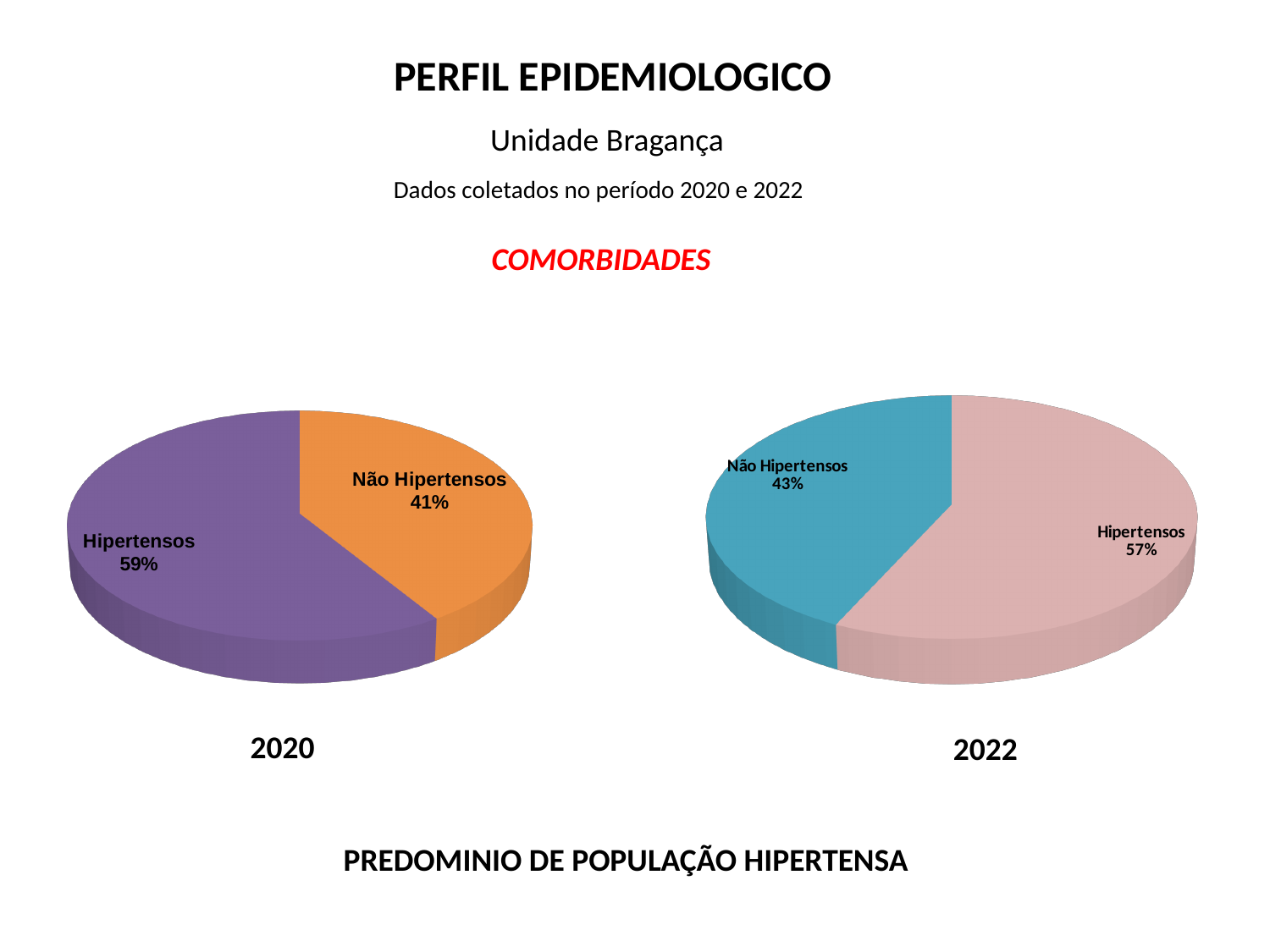
Is the Hipertensos share larger in the 2020 pie chart or the 2022 pie chart? 2020 How many slices does the 2020 pie chart have? 2 In the 2020 pie chart, what percentage is labelled for Hipertensos? 59% In the 2022 pie chart, what colour is the Não Hipertensos slice? Teal/blue In the 2020 pie chart, what percentage is labelled for Não Hipertensos? 41% In the 2020 pie chart, what is the difference in percentage points between Hipertensos and Não Hipertensos? 18 In the 2022 pie chart, which slice is the smallest? Não Hipertensos In the 2022 pie chart, what percentage is labelled for Não Hipertensos? 43% What type of chart is used for the 2022 data? Pie chart In the 2022 pie chart, what is the difference in percentage points between Hipertensos and Não Hipertensos? 14 In the 2020 pie chart, which slice is the largest? Hipertensos In the 2022 pie chart, what percentage is labelled for Hipertensos? 57%